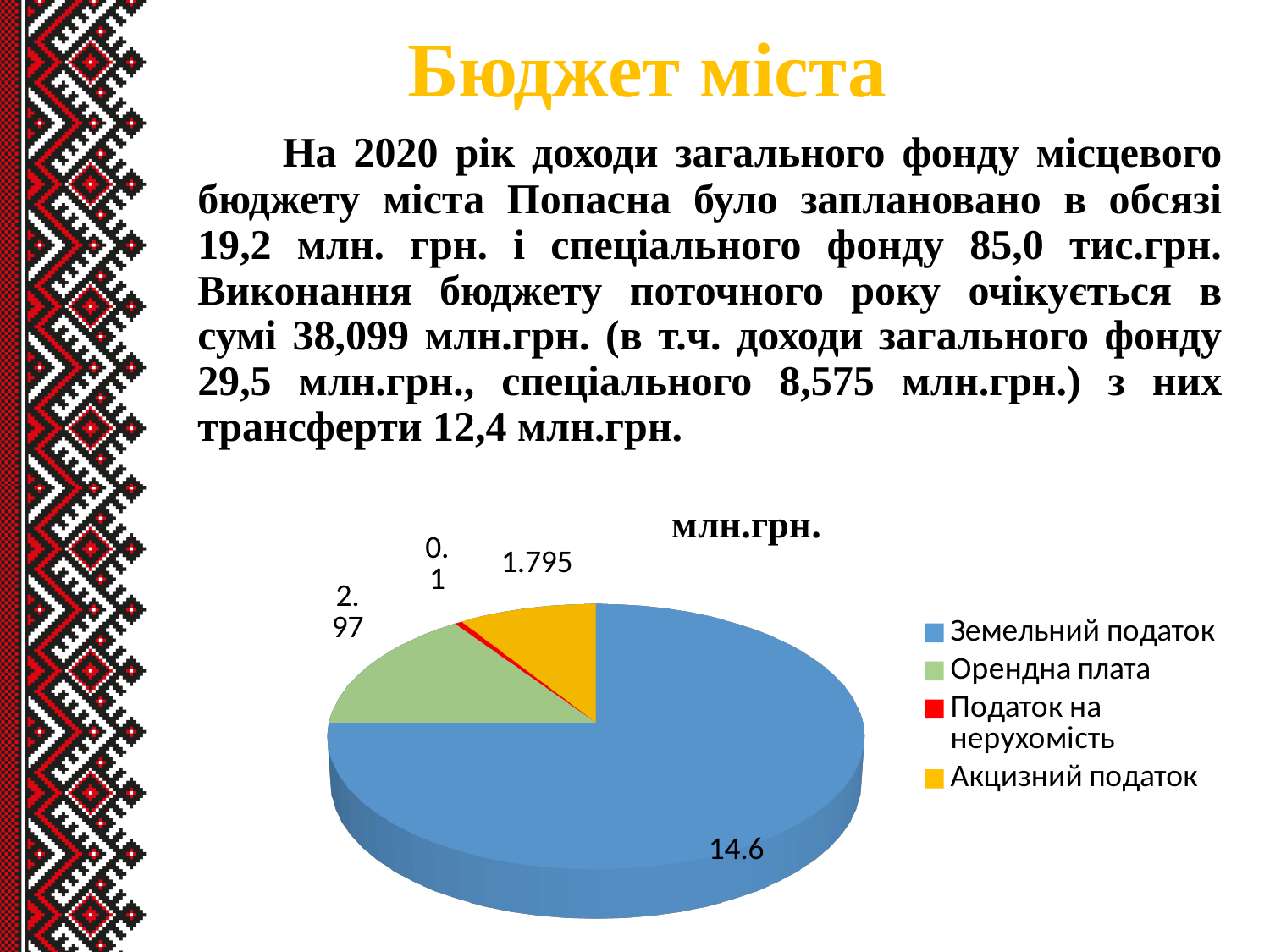
Which category has the largest slice in the pie chart? Земельний податок What is the difference between the values for Земельний податок and Орендна плата? 11.63 How many slices does the pie chart have? 4 Which category has the smallest slice in the pie chart? Податок на нерухомість What is the value for Орендна плата in the pie chart? 2.97 What is the value for Земельний податок in the pie chart? 14.6 What is the title of the pie chart? млн.грн. What is the value for Акцизний податок in the pie chart? 1.795 What is the value for Податок на нерухомість in the pie chart? 0.1 What type of chart is shown on the slide? Pie chart What colour is the Акцизний податок slice in the pie chart? Yellow Which is larger, Орендна плата or Акцизний податок? Орендна плата